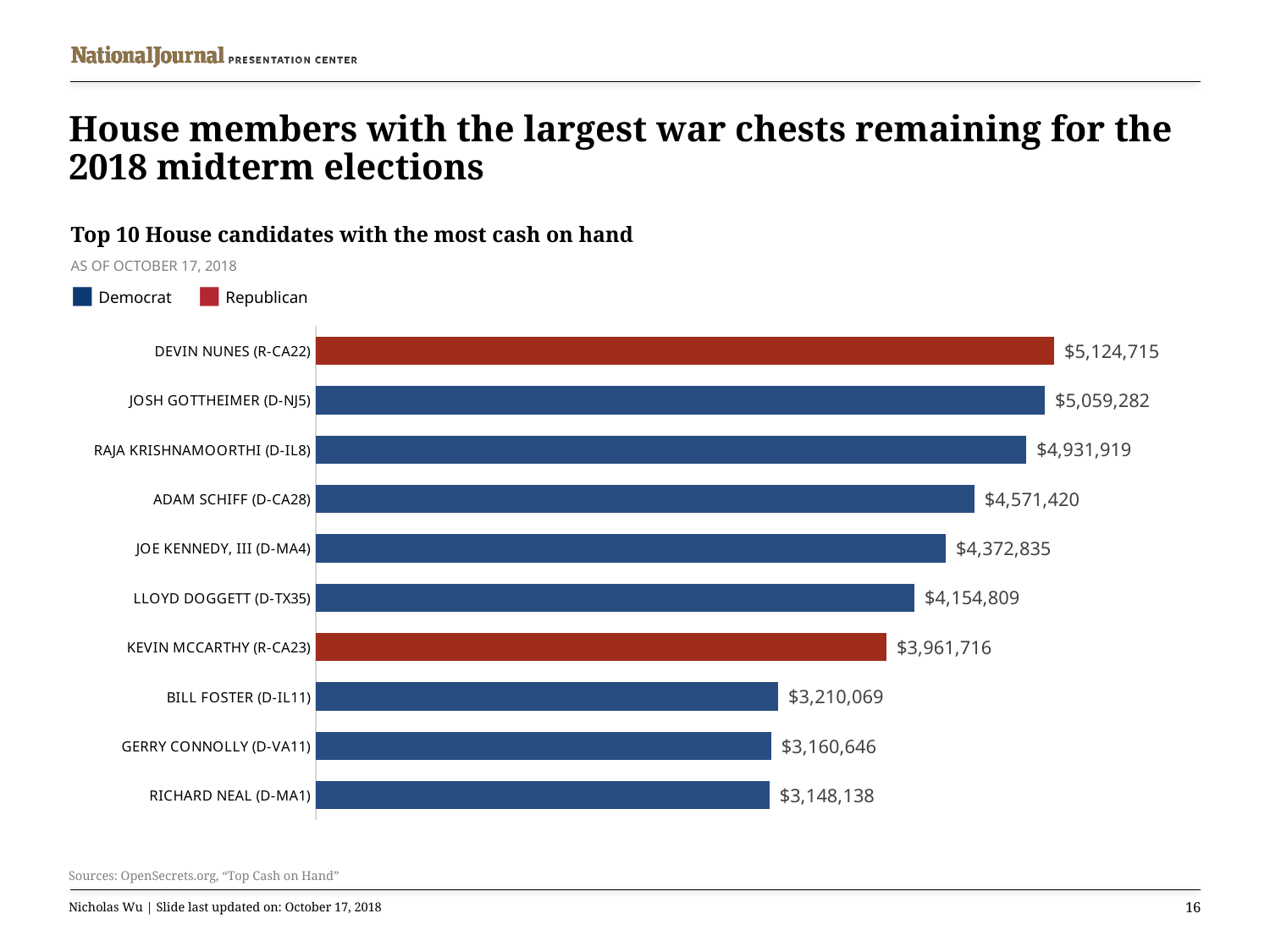
What type of chart is shown on the slide? Bar chart Which candidate has the least cash on hand? Richard Neal (D-MA1) What is the difference in cash on hand between Devin Nunes (R-CA22) and Josh Gottheimer (D-NJ5)? $65,433 What is the cash on hand for Devin Nunes (R-CA22)? $5,124,715 What is the cash on hand for Kevin McCarthy (R-CA23)? $3,961,716 How many Republican candidates appear in the chart? 2 Who has more cash on hand, Joe Kennedy, III (D-MA4) or Bill Foster (D-IL11)? Joe Kennedy, III (D-MA4) Which candidate has the most cash on hand? Devin Nunes (R-CA22) What is the cash on hand for Adam Schiff (D-CA28)? $4,571,420 How many candidates are shown in the chart? 10 How many entries does the legend list? 2 What is the difference in cash on hand between Lloyd Doggett (D-TX35) and Kevin McCarthy (R-CA23)? $193,093